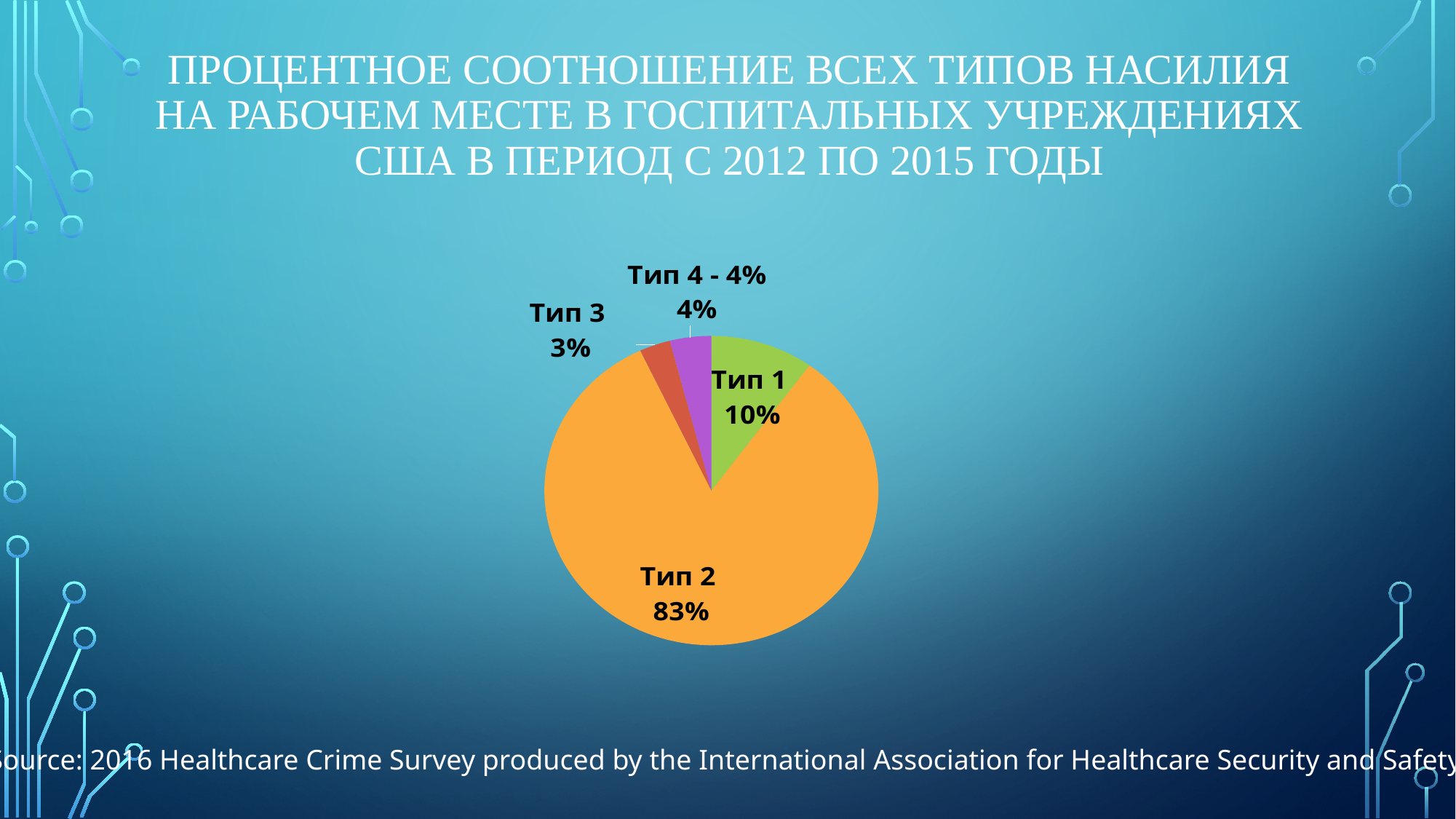
What is the value shown for Тип 1? 10% Which type has the largest slice of the pie? Тип 2 What share of the pie does Тип 2 have? 83% Which type has the smallest slice of the pie? Тип 3 What is the combined share of Тип 3 and Тип 4? 7% What kind of chart is shown on the slide? pie chart What is the difference between the shares of Тип 2 and Тип 1? 73% How many slices does the pie chart have? 4 Which is larger, the share of Тип 1 or the share of Тип 4? Тип 1 What is the value shown for Тип 3? 3% What is the value shown for Тип 4? 4% What colour is the slice for Тип 2? orange